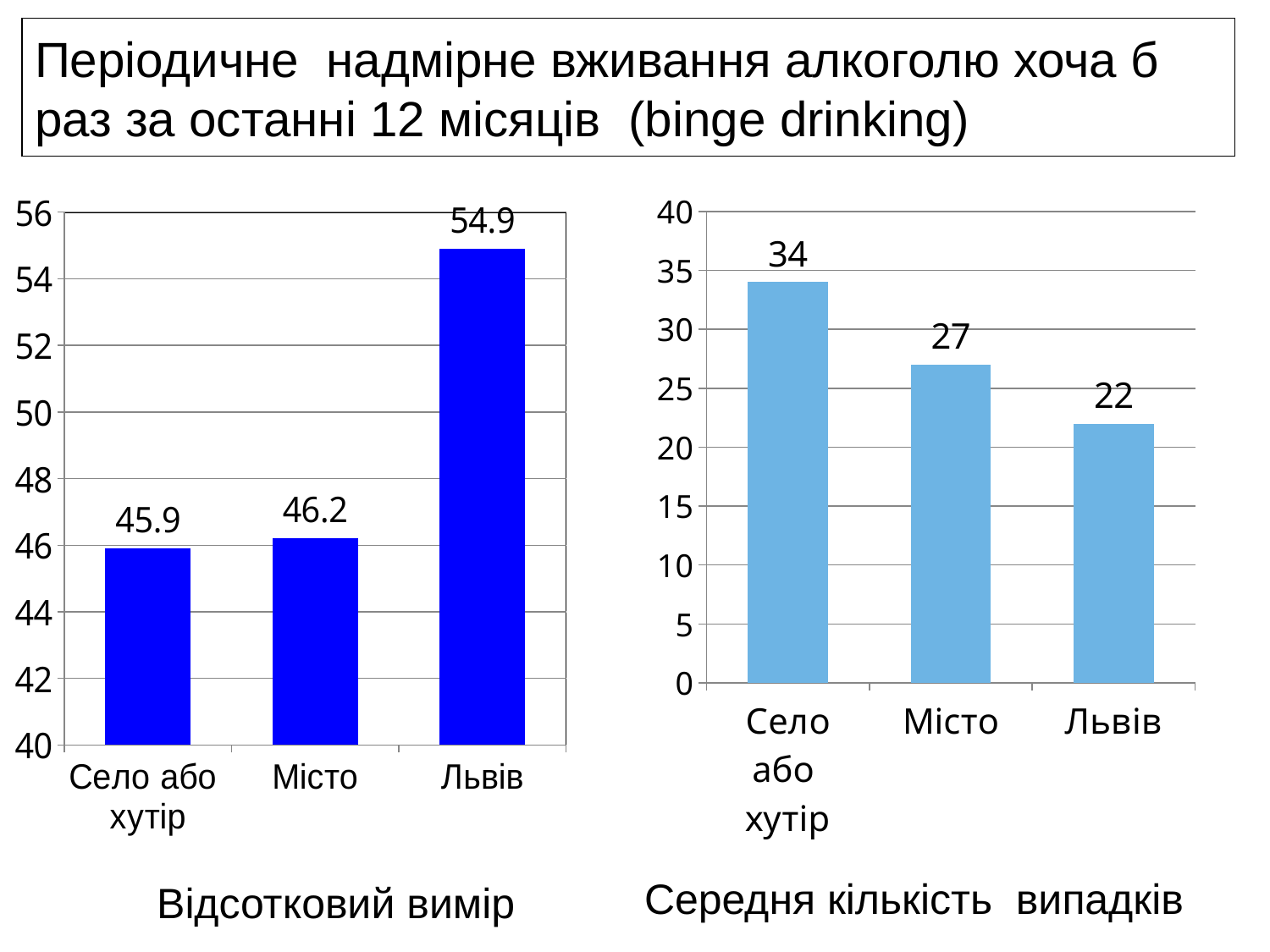
In the left chart (Відсотковий вимір), which category has the highest value? Львів In the left chart (Відсотковий вимір), which is larger: the value for Місто or the value for Львів? Львів In the right chart (Середня кількість випадків), what is the value for Місто? 27 In the left chart (Відсотковий вимір), what is the difference between the values for Львів and Місто? 8.7 What type of chart is the left chart (Відсотковий вимір)? Bar chart In the right chart (Середня кількість випадків), do the values rise or fall from left to right? Fall In the left chart (Відсотковий вимір), what is the value for Село або хутір? 45.9 In the right chart (Середня кількість випадків), which category has the lowest value? Львів In the right chart (Середня кількість випадків), what is the difference between the values for Село або хутір and Львів? 12 In the right chart (Середня кількість випадків), which category has the highest value? Село або хутір How many categories are shown in the right chart (Середня кількість випадків)? 3 In the left chart (Відсотковий вимір), what is the value for Львів? 54.9